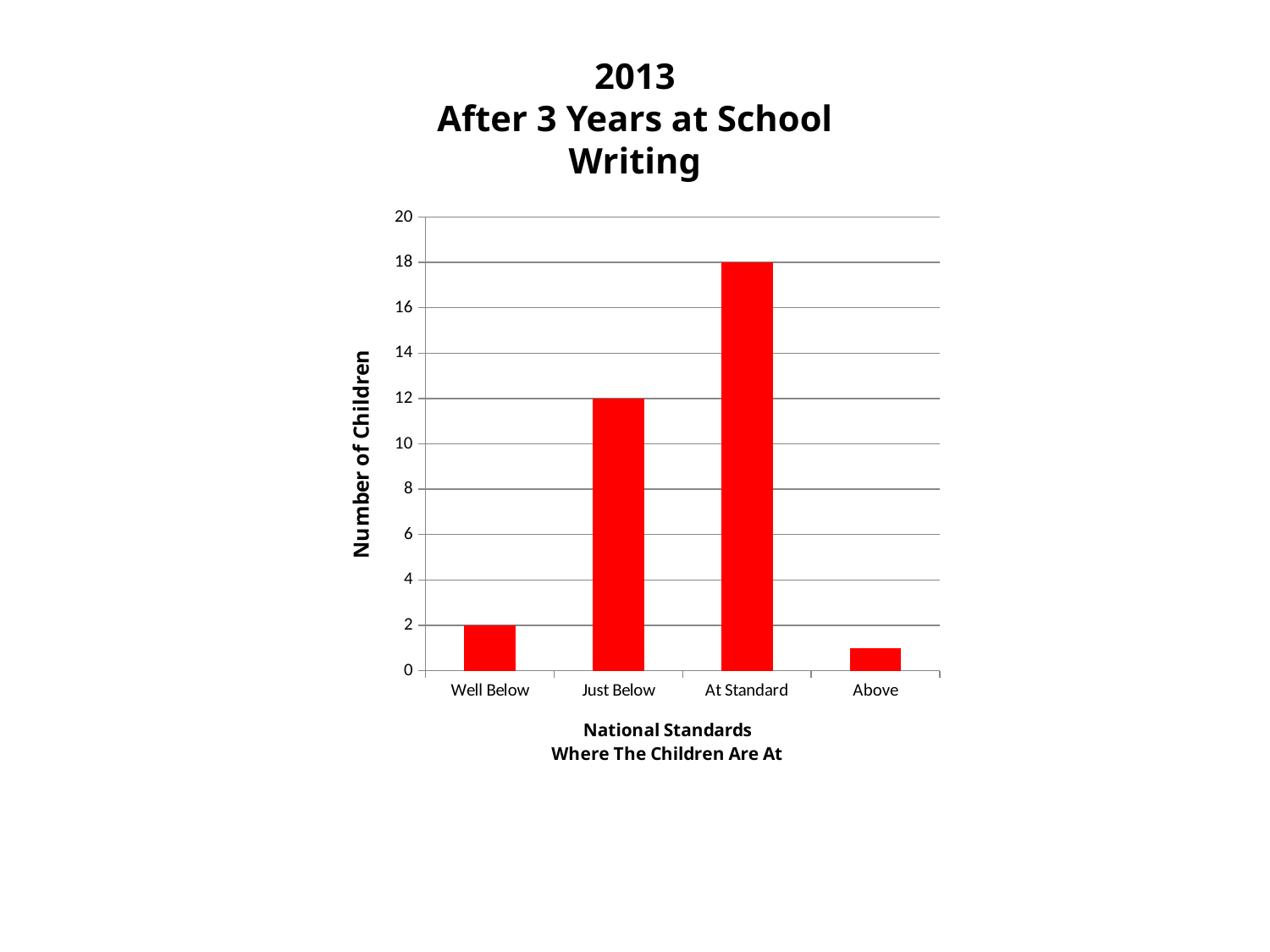
What kind of chart is shown on the slide? Bar chart How many children are Just Below? 12 What is the label of the vertical axis? Number of Children Which category has the highest number of children? At Standard What is the difference between the number of children At Standard and Just Below? 6 What is the title of the chart? 2013 After 3 Years at School Writing Which category has the lowest number of children? Above How many categories are shown on the x axis? 4 How many children are Well Below? 2 How many children are At Standard? 18 Which is larger, the value for Just Below or the value for Well Below? Just Below Is the value for Above greater or less than 2? less